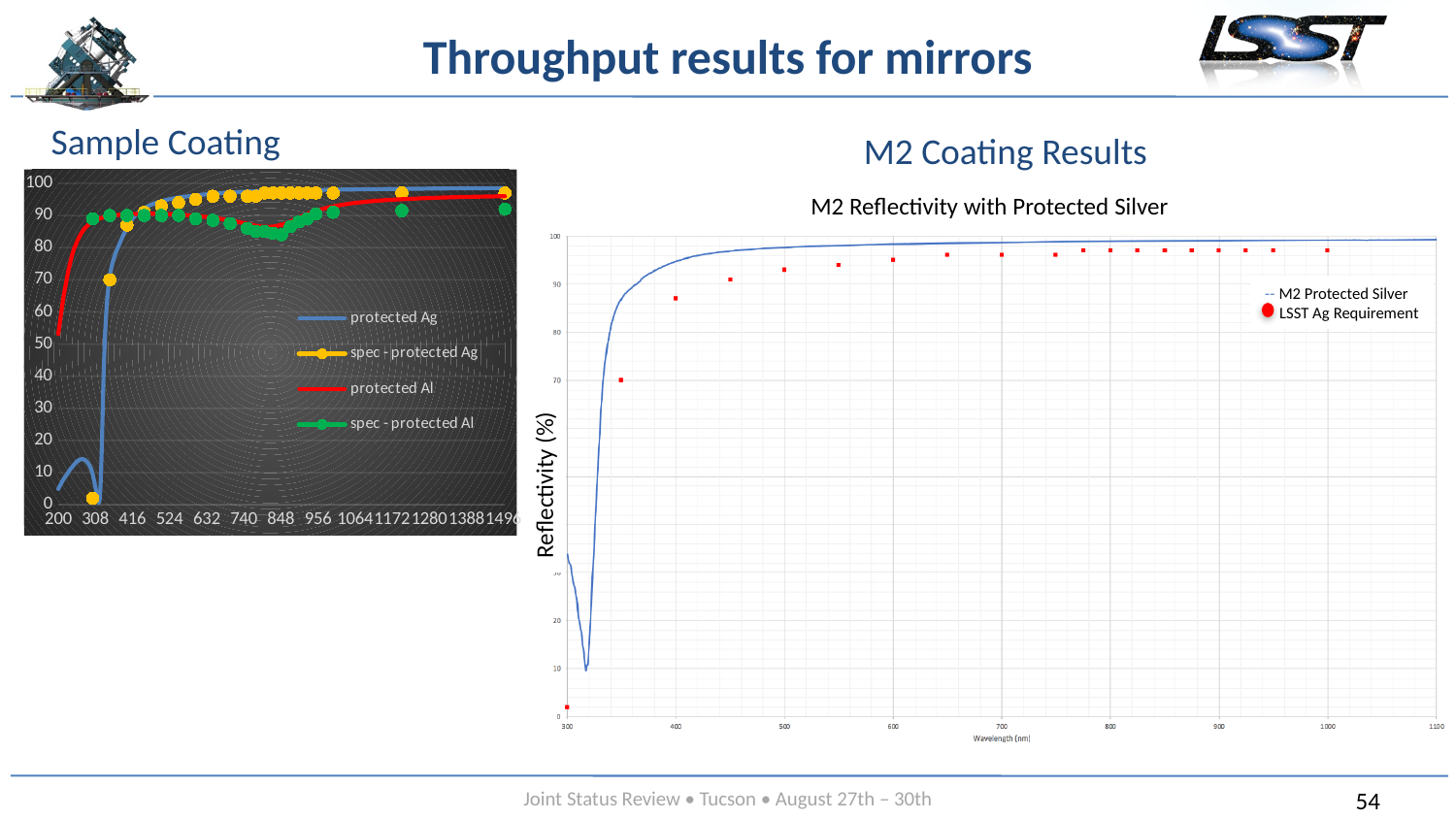
How many series does the legend of the Sample Coating chart list? 4 In the M2 Reflectivity with Protected Silver chart, between 400 nm and 1100 nm does the M2 Protected Silver line rise or fall? rise In the Sample Coating chart, between 308 and 524 does the protected Ag line rise or fall? rise In the M2 Reflectivity with Protected Silver chart, what is the label of the y axis? Reflectivity (%) In the Sample Coating chart, is the value for protected Al at 200 greater or less than 60? less In the Sample Coating chart, is the value for spec - protected Ag at 308 greater or less than 10? less In the Sample Coating chart, at 848, which is larger: protected Ag or protected Al? protected Ag How many series does the legend of the M2 Reflectivity with Protected Silver chart list? 2 In the Sample Coating chart, which series is drawn in red? protected Al In the M2 Reflectivity with Protected Silver chart, is the LSST Ag Requirement value at 350 nm greater or less than 80? less What kind of chart is the Sample Coating chart on the left? line chart